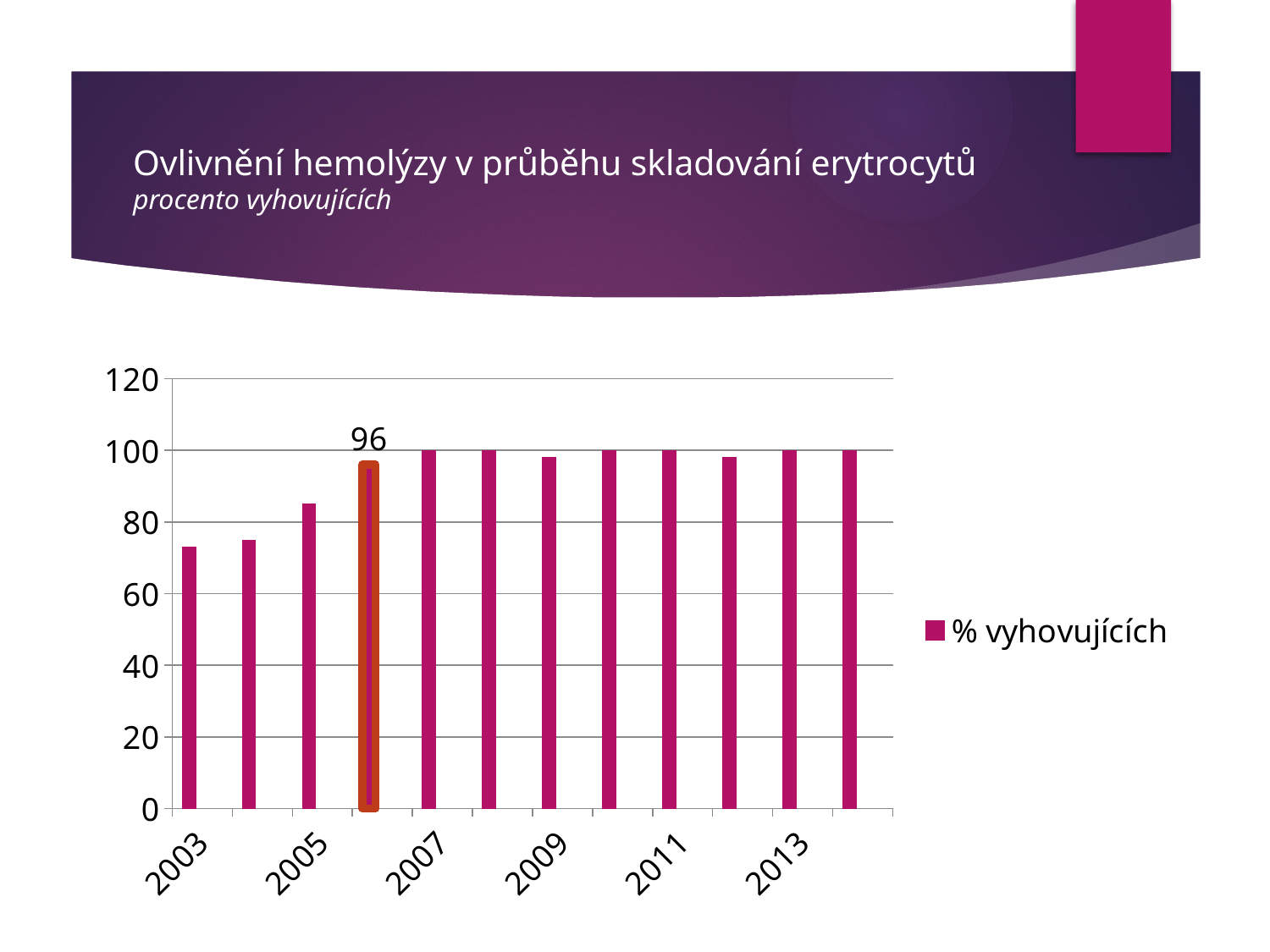
What kind of chart is shown on the slide? bar chart Which is larger, the value for 2003 or the value for 2005? 2005 How many bars are plotted on the chart? 12 Is the value for 2005 greater or less than 80? greater What is the value for 2007? 100 Is the value for 2011 greater or less than 80? greater Which is larger, the value for 2003 or the value for 2007? 2007 How many series does the legend list? 1 Do the values rise or fall from 2003 to 2007? rise What is the value of the bar outlined in orange (between 2005 and 2007)? 96 What value is printed as a data label on the chart? 96 Is the value for 2003 greater or less than 80? less